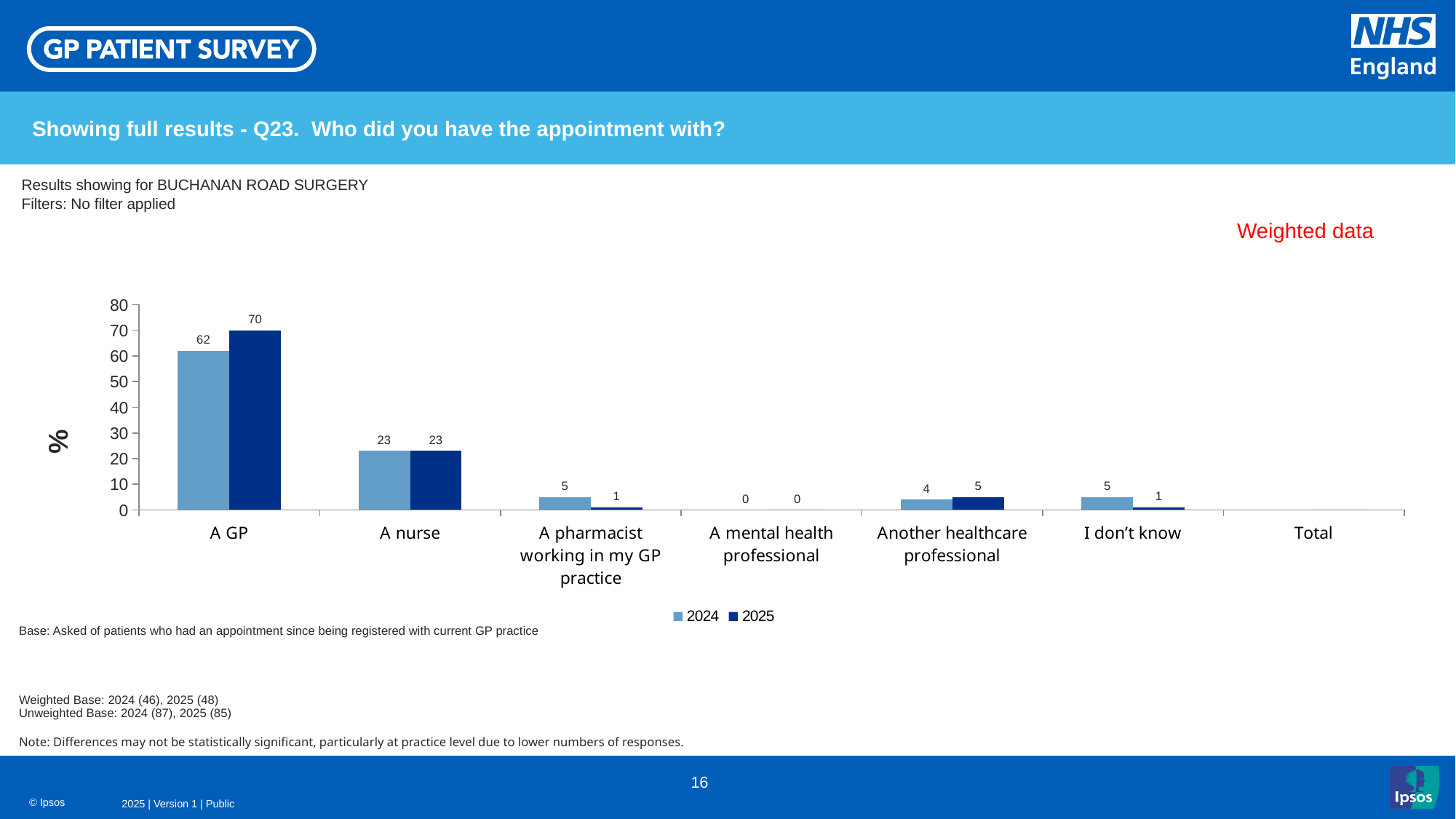
What is the 2024 value for A nurse? 23 Is the 2024 value for A GP greater or less than 50? greater What kind of chart is shown on the slide? Bar chart Which category has the lowest 2024 value? A mental health professional Which is larger for I don't know: the 2024 value or the 2025 value? 2024 How many series does the legend list? 2 What label is shown on the vertical axis? % What is the 2025 value for A GP? 70 What is the difference between the 2025 and 2024 values for A GP? 8 What is the 2025 value for A pharmacist working in my GP practice? 1 Which category has the highest 2025 value? A GP What is the 2024 value for Another healthcare professional? 4